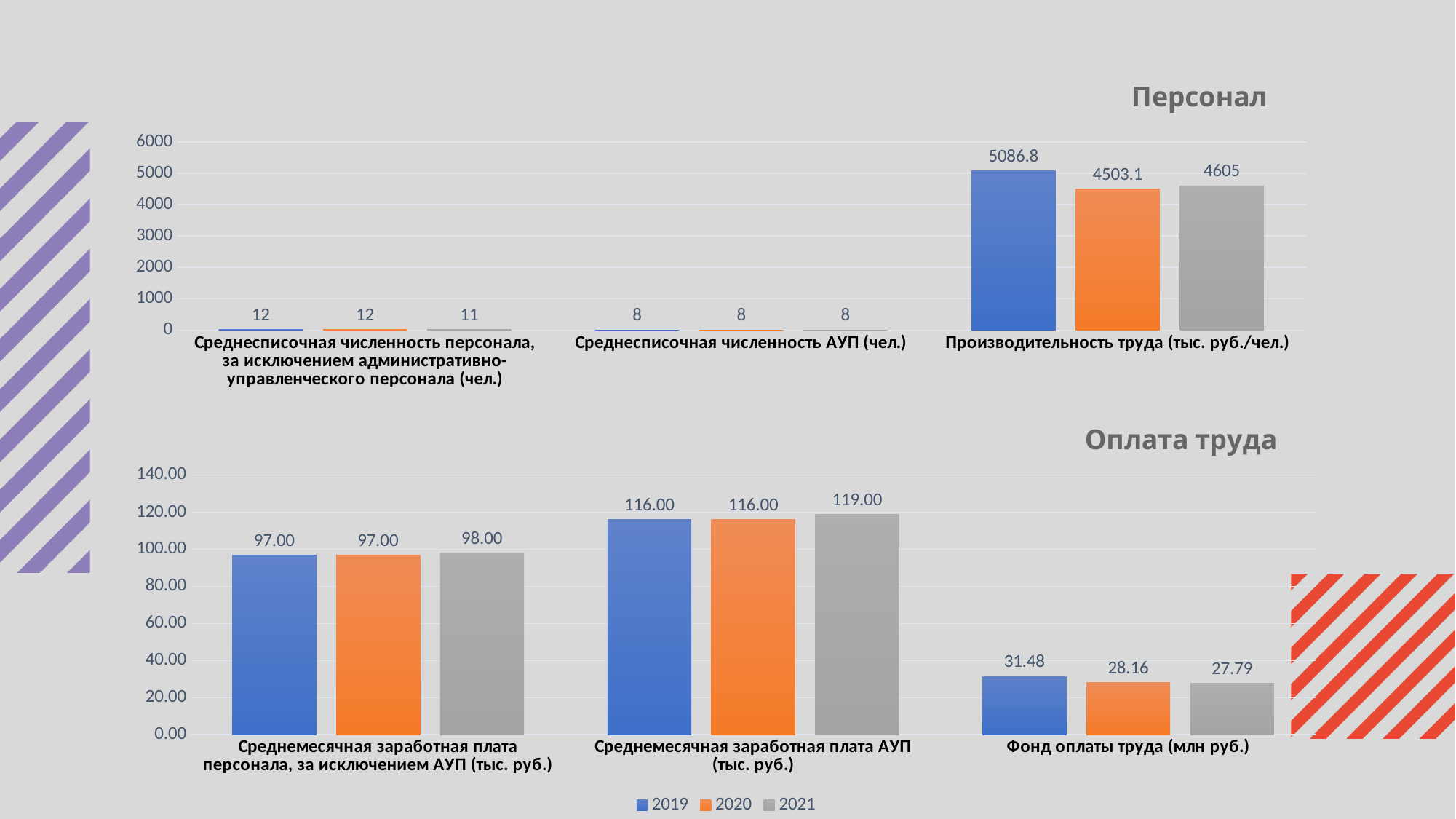
In the "Оплата труда" chart, does the value of Фонд оплаты труда (млн руб.) rise or fall from 2019 to 2021? fall What kind of chart is the "Оплата труда" chart? bar chart In the "Оплата труда" chart, what is the value of Фонд оплаты труда (млн руб.) for 2020? 28.16 In the "Персонал" chart, what is the difference between the 2019 and 2020 values of Производительность труда (тыс. руб./чел.)? 583.7 In the "Персонал" chart, which year has the highest value for Производительность труда (тыс. руб./чел.)? 2019 In the "Оплата труда" chart, how many series does the legend list? 3 In the "Оплата труда" chart, what is the value of Среднемесячная заработная плата АУП (тыс. руб.) for 2021? 119.00 In the "Персонал" chart, what is the value of Производительность труда (тыс. руб./чел.) for 2019? 5086.8 In the "Персонал" chart, what is the value of Производительность труда (тыс. руб./чел.) for 2021? 4605 In the "Оплата труда" chart, what is the difference between the 2019 and 2021 values of Фонд оплаты труда (млн руб.)? 3.69 In the "Персонал" chart, how many categories are shown on the x axis? 3 In the "Персонал" chart, what is the value of Среднесписочная численность персонала, за исключением административно-управленческого персонала (чел.) for 2021? 11